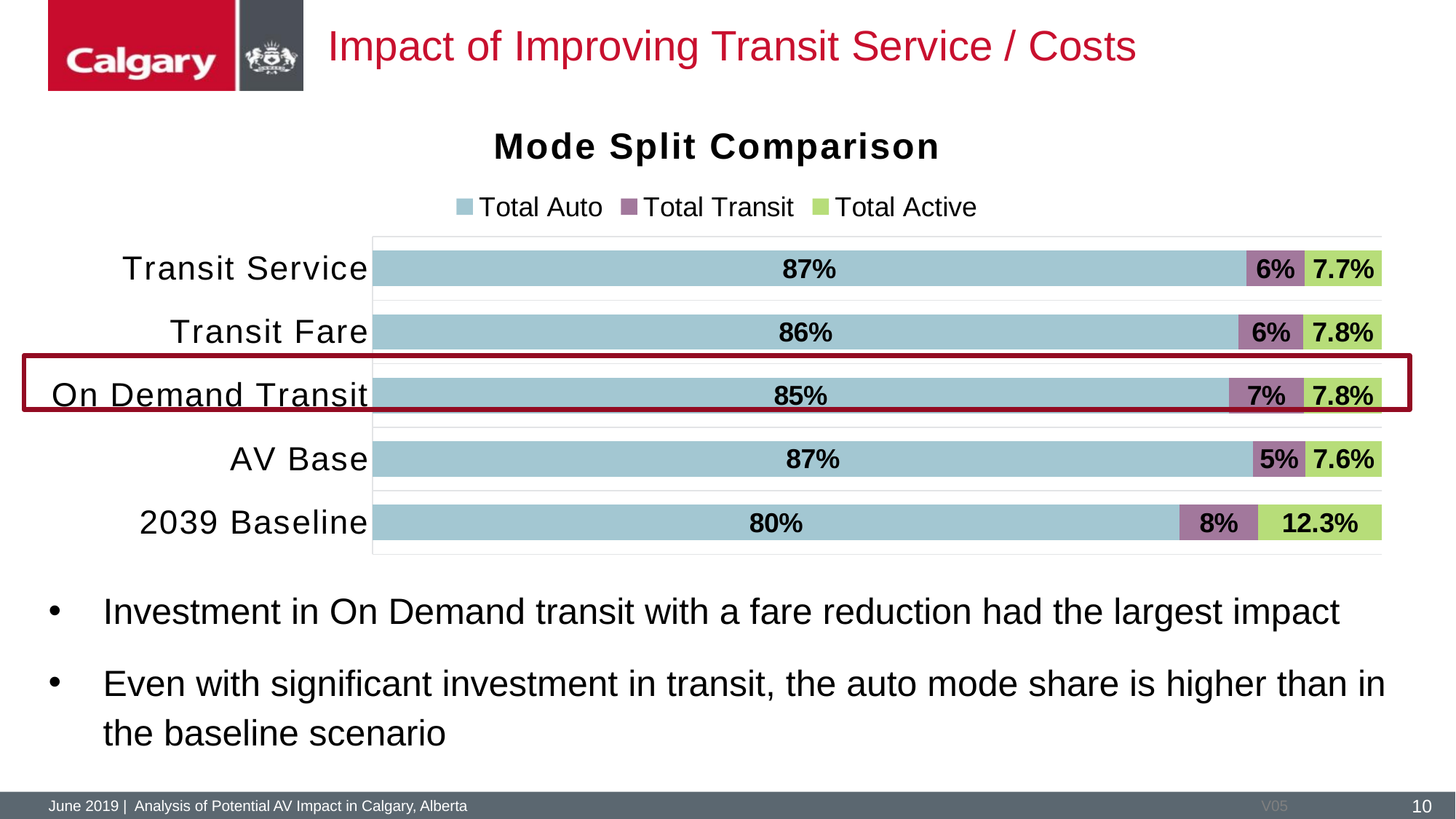
Which scenario has the lowest Total Transit share? AV Base Which has a larger Total Auto share, Transit Fare or On Demand Transit? Transit Fare What is the difference in Total Active share between the 2039 Baseline and AV Base scenarios? 4.7 percentage points What is the title of the chart? Mode Split Comparison What type of chart is shown on the slide? Stacked bar chart Which scenario has the lowest Total Auto share? 2039 Baseline What is the Total Auto share for the 2039 Baseline scenario? 80% How many scenarios (categories) are shown in the chart? 5 How many series does the legend list? 3 Which scenario has the highest Total Active share? 2039 Baseline What is the Total Active share for the On Demand Transit scenario? 7.8% What is the Total Transit share for the AV Base scenario? 5%